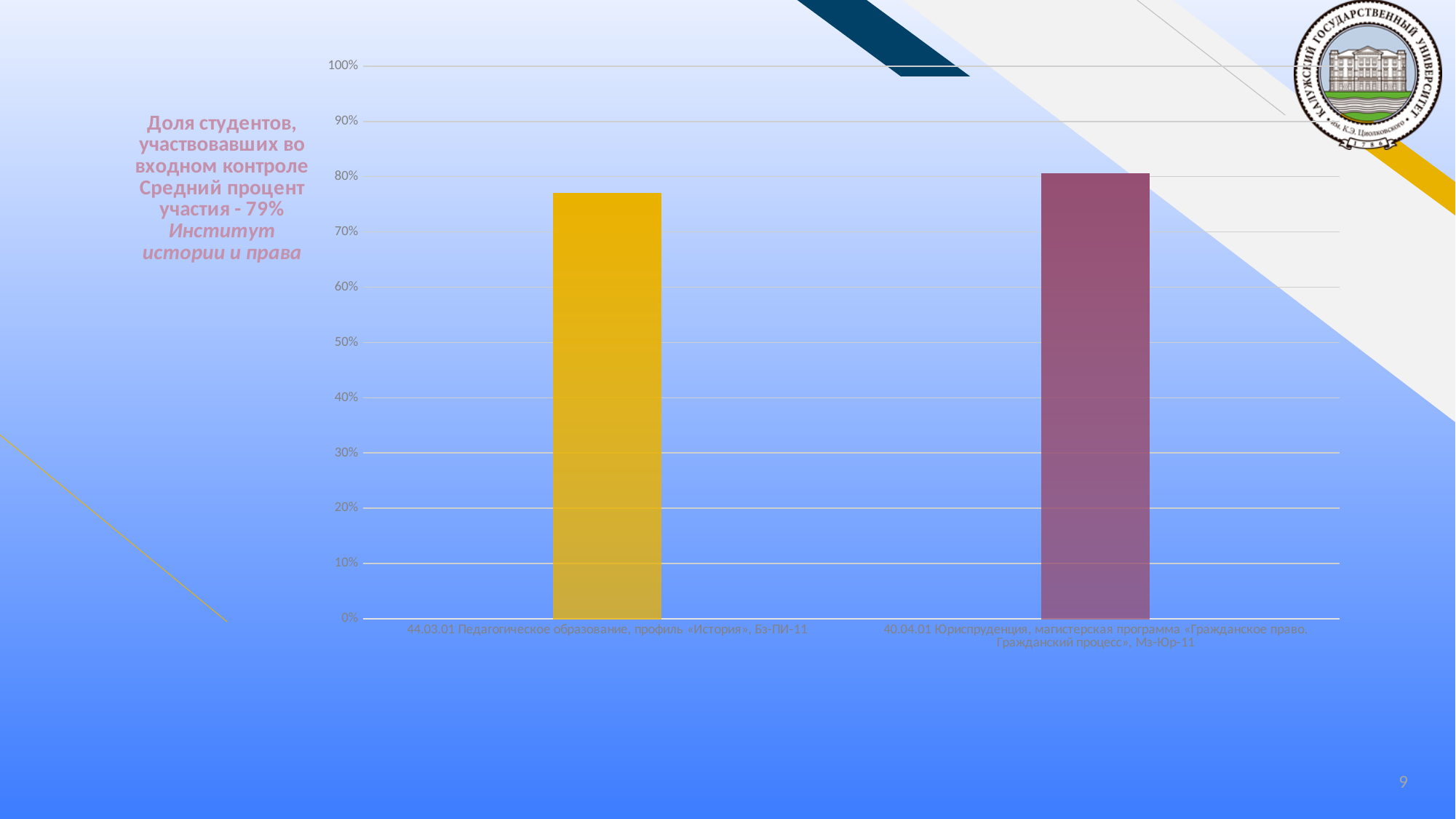
Is the value for 40.04.01 Юриспруденция, магистерская программа «Гражданское право. Гражданский процесс», Мз-Юр-11 greater or less than 90%? less Is the value for 44.03.01 Педагогическое образование, профиль «История», Бз-ПИ-11 greater or less than 70%? greater How many categories (bars) does the chart show? 2 What is the maximum value shown on the chart's vertical axis? 100% Is the value for 40.04.01 Юриспруденция, магистерская программа «Гражданское право. Гражданский процесс», Мз-Юр-11 greater or less than 70%? greater Which category has the lowest bar? 44.03.01 Педагогическое образование, профиль «История», Бз-ПИ-11 According to the text next to the chart, what is the average participation percentage (Средний процент участия)? 79% Which category has the highest bar? 40.04.01 Юриспруденция, магистерская программа «Гражданское право. Гражданский процесс», Мз-Юр-11 What kind of chart is shown on the slide? bar chart Which bar is taller: Бз-ПИ-11 or Мз-Юр-11? Мз-Юр-11